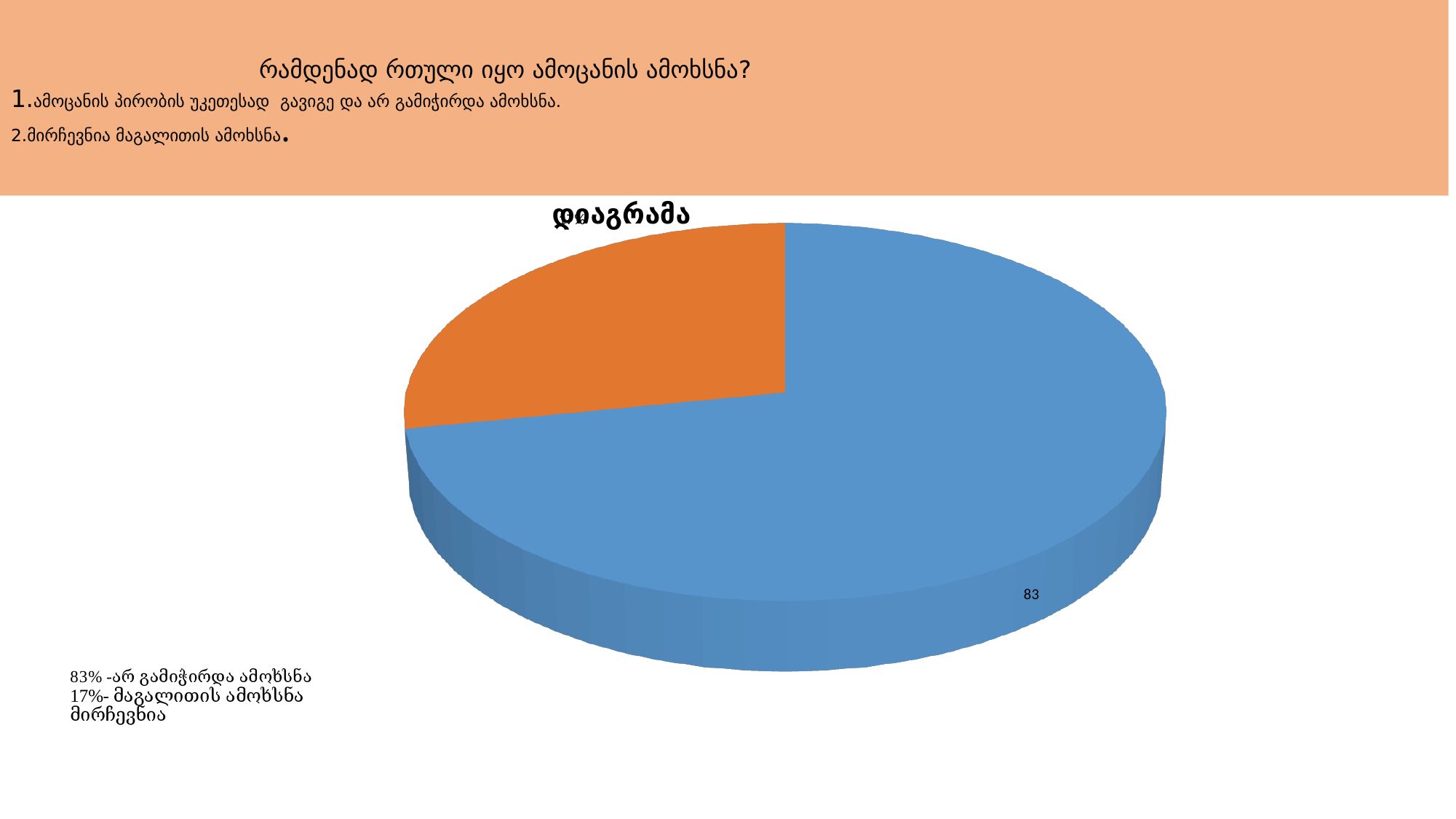
According to the text on the slide, what percentage corresponds to "მაგალითის ამოხსნა მირჩევნია"? 17% What is the title of the chart? დიაგრამა What data label is printed on the blue slice of the pie chart? 83 Which slice of the pie chart is the smallest? the orange slice What is the difference in percentage points between the two slices of the pie chart? 66 Which slice is larger, the blue one or the orange one? the blue one What share of the pie does the blue slice represent? 83% How many slices does the pie chart have? 2 Which slice of the pie chart is the largest? the blue slice What colour is the slice representing "მაგალითის ამოხსნა მირჩევნია" (17%)? orange According to the text on the slide, what percentage corresponds to "არ გამიჭირდა ამოხსნა"? 83% What kind of chart is shown on the slide? pie chart